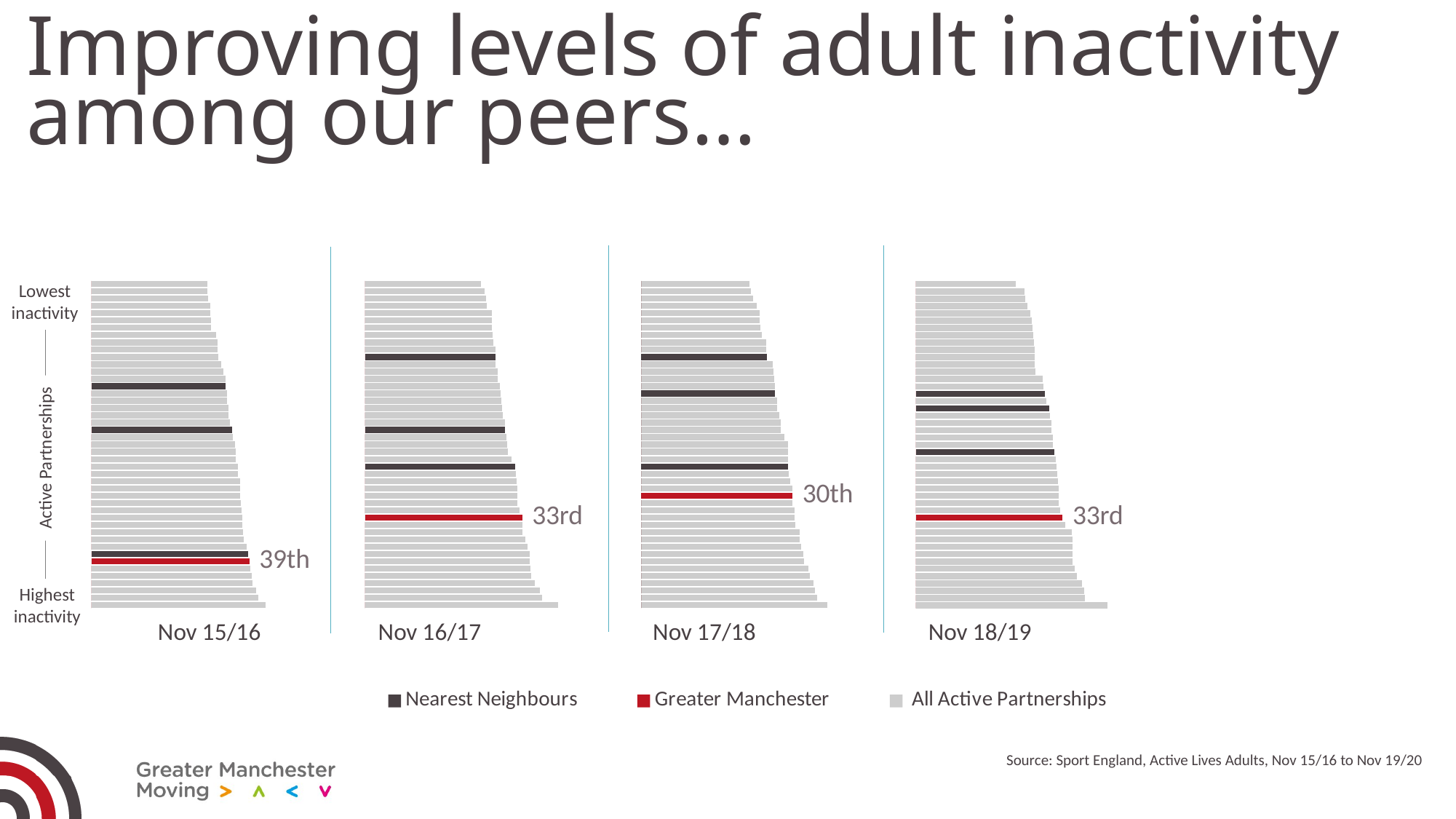
What rank is shown for Greater Manchester in the Nov 16/17 chart? 33rd In which period does Greater Manchester have its best (lowest-numbered) rank? Nov 17/18 Is Greater Manchester's rank number higher in Nov 15/16 or in Nov 17/18? Nov 15/16 What rank is shown for Greater Manchester in the Nov 15/16 chart? 39th What rank is shown for Greater Manchester in the Nov 18/19 chart? 33rd Which colour represents Greater Manchester in the legend? Red By how many places did Greater Manchester's rank change between Nov 15/16 (39th) and Nov 16/17 (33rd)? 6 What rank is shown for Greater Manchester in the Nov 17/18 chart? 30th How many series does the legend list? 3 How many time periods are shown across the charts? 4 In which period does Greater Manchester have its worst (highest-numbered) rank? Nov 15/16 What kind of chart is used on this slide? Bar chart